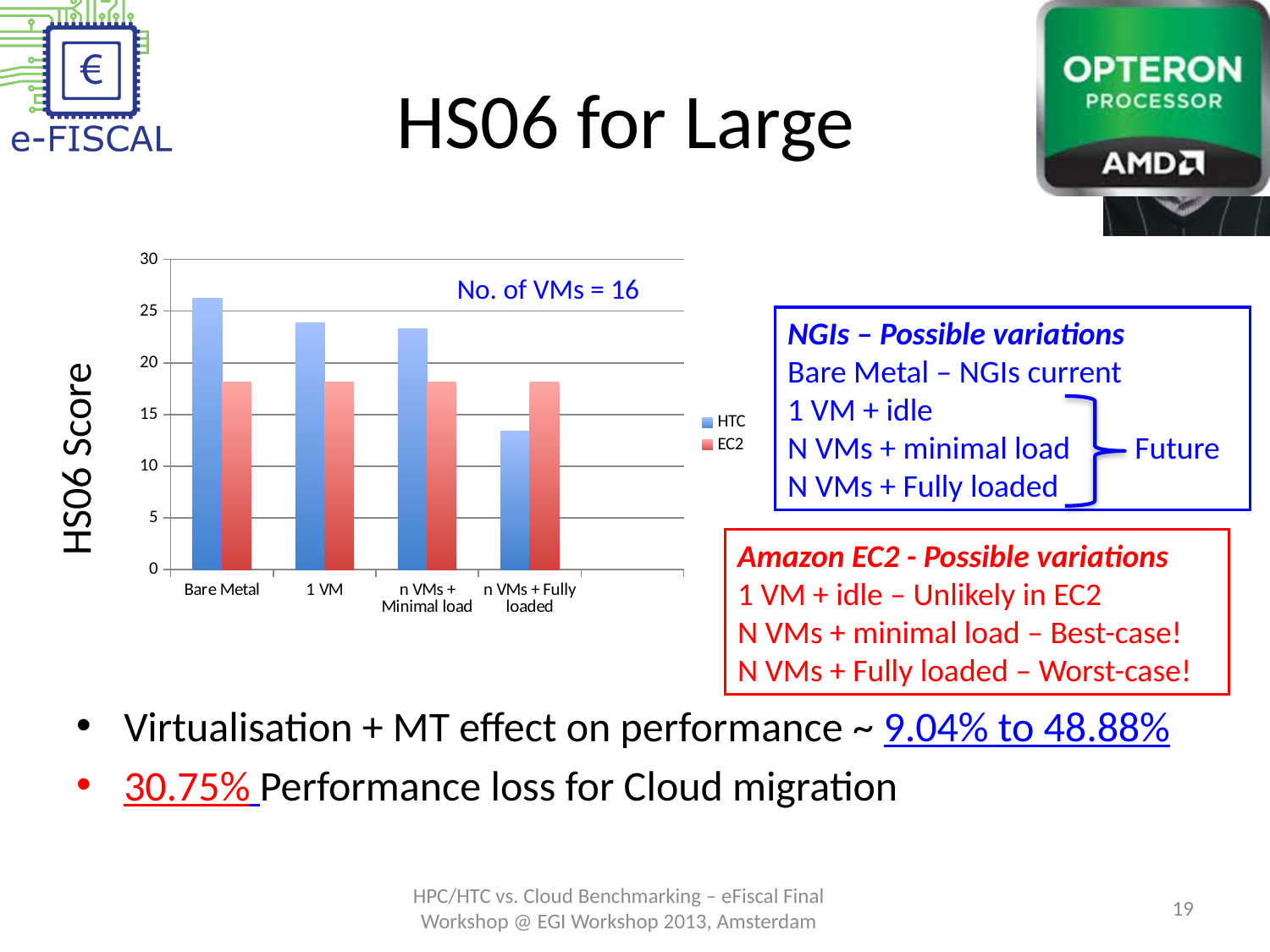
Which category has the highest HTC value? Bare Metal For Bare Metal, which series has the larger value, HTC or EC2? HTC How many categories are shown on the x axis of the chart? 4 What kind of chart is shown on the slide? bar chart For n VMs + Fully loaded, which series has the larger value, HTC or EC2? EC2 How many series does the chart legend list? 2 Is the HTC value for Bare Metal greater or less than 25? greater What is the label on the vertical axis of the chart? HS06 Score Is the EC2 value for 1 VM greater or less than 20? less Do the HTC values rise or fall from Bare Metal to n VMs + Fully loaded? fall Is the HTC value for n VMs + Fully loaded greater or less than 15? less Which category has the lowest HTC value? n VMs + Fully loaded